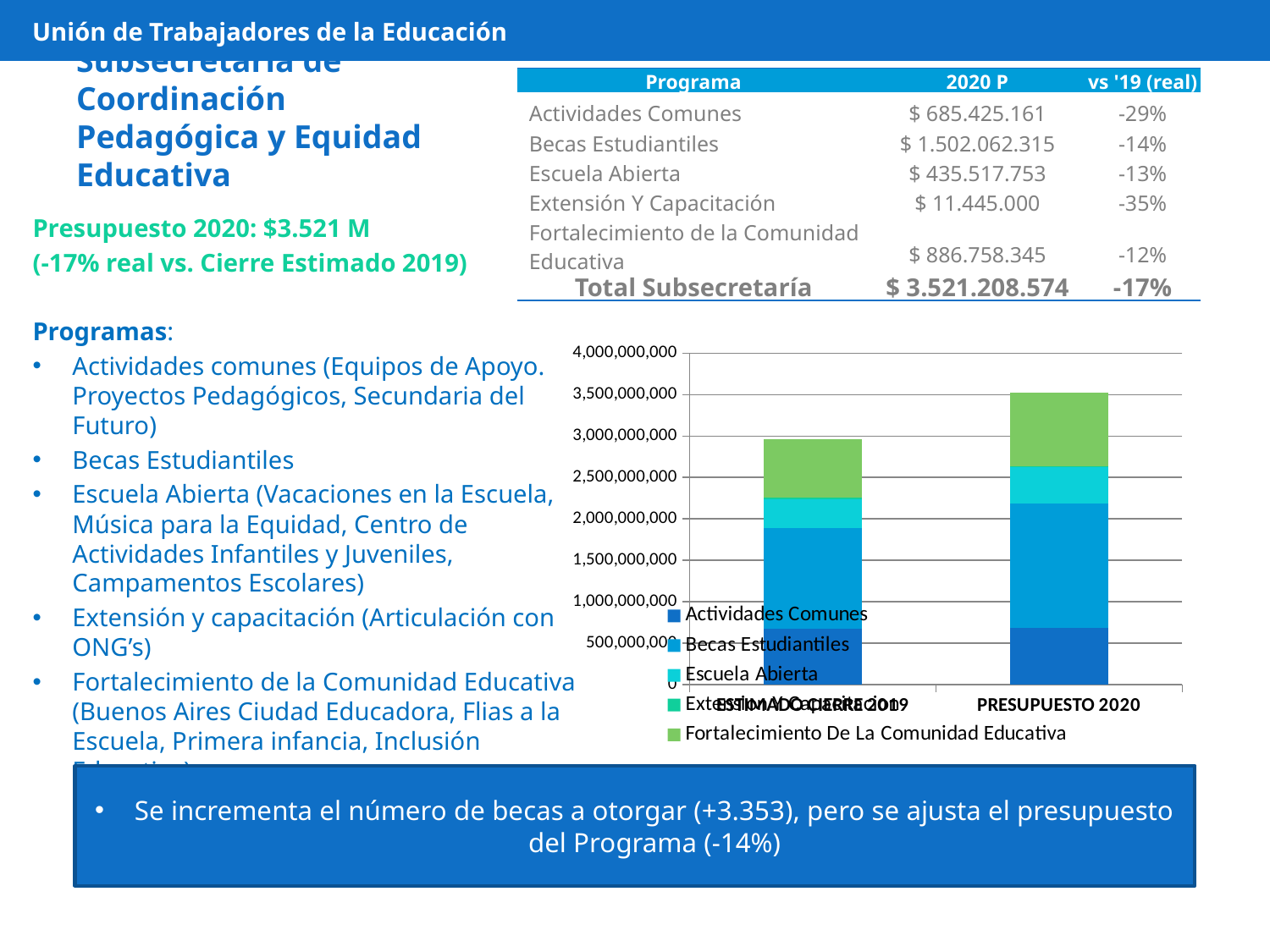
Which series is the bottom segment of each stacked bar? Actividades Comunes Is the total of the PRESUPUESTO 2020 bar greater or less than 4,000,000,000? less Do the stacked bar totals rise or fall from ESTIMADO CIERRE 2019 to PRESUPUESTO 2020? rise How many bars (categories) are plotted on the chart? 2 Is the total of the PRESUPUESTO 2020 bar greater or less than 3,000,000,000? greater What kind of chart is shown on the slide? bar chart Which series is the top segment of each stacked bar? Fortalecimiento De La Comunidad Educativa Which bar is taller, ESTIMADO CIERRE 2019 or PRESUPUESTO 2020? PRESUPUESTO 2020 How many series does the chart legend list? 5 Is the total of the ESTIMADO CIERRE 2019 bar greater or less than 2,500,000,000? greater